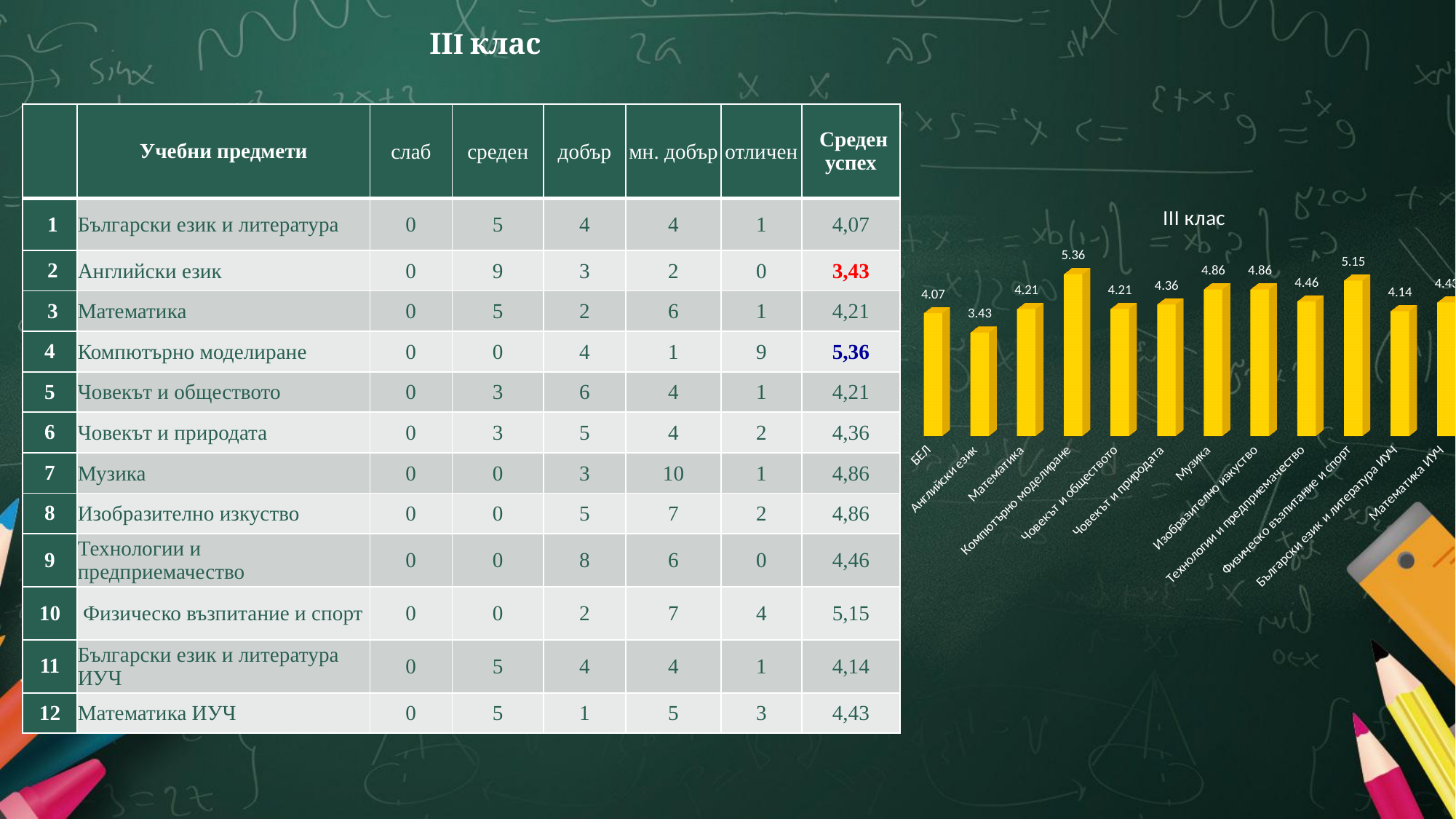
What is the title of the chart? III клас How many bars (categories) does the chart show? 12 Which is larger in the chart: the value for Човекът и природата or the value for Технологии и предприемачество? Технологии и предприемачество What type of chart is shown on the slide? Bar chart Which category has the lowest value in the chart? Английски език What is the difference between the values for Компютърно моделиране and Английски език in the chart? 1.93 What is the difference between the values for Физическо възпитание и спорт and БЕЛ in the chart? 1.08 What is the value for Музика in the chart? 4.86 What is the value for Компютърно моделиране in the chart? 5.36 Which category has the highest value in the chart? Компютърно моделиране What is the value for Физическо възпитание и спорт in the chart? 5.15 What is the value for Английски език in the chart? 3.43